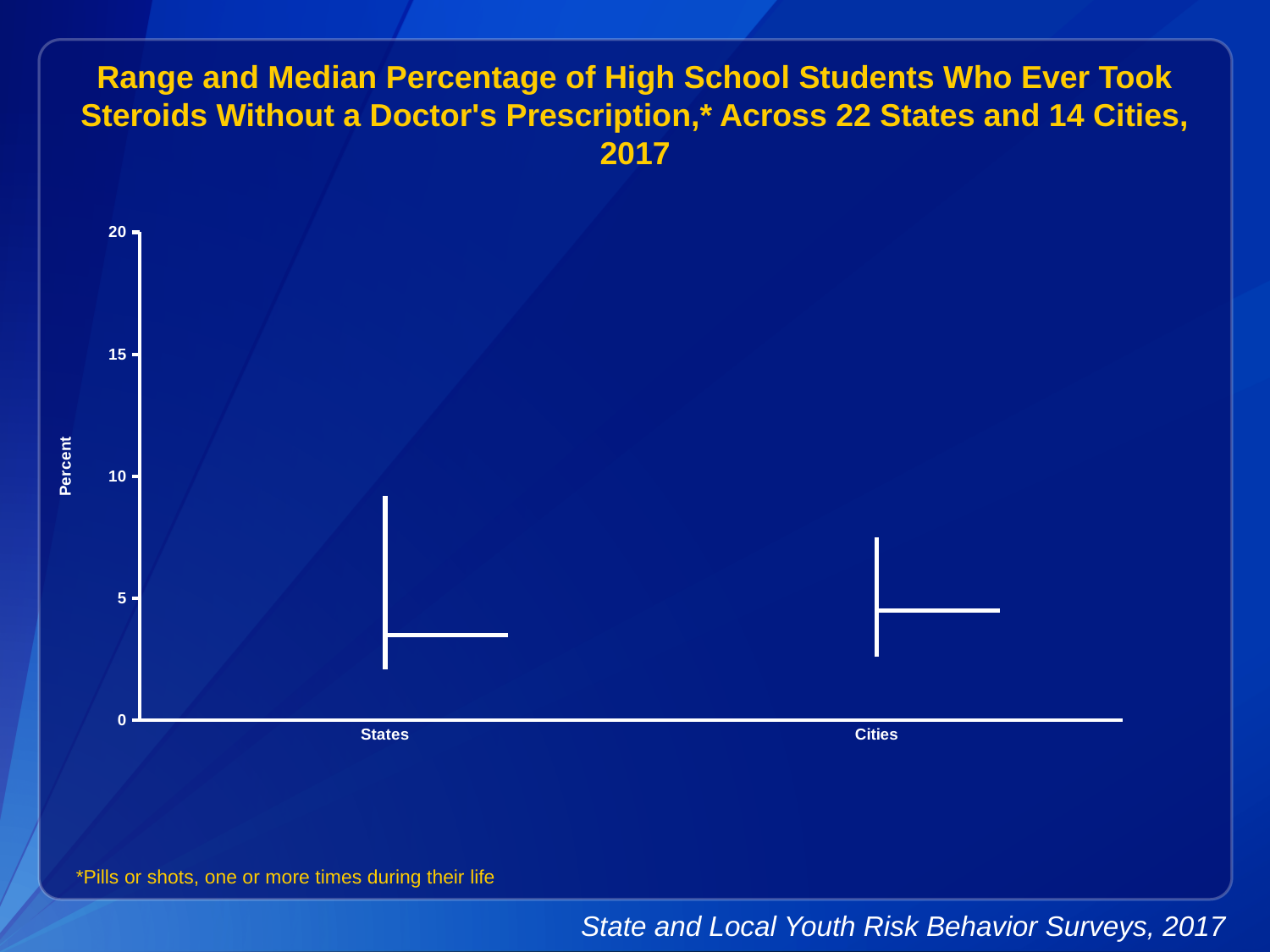
Which category has the higher median percentage, States or Cities? Cities Which category has the higher maximum (top of range), States or Cities? States How many categories are shown on the x axis of the chart? 2 Is the top of the range for Cities greater or less than 10? less Is the bottom of the range for Cities greater or less than 5? less Is the top of the range for States greater or less than 10? less What is the highest value shown on the y axis? 20 What is the label of the y axis? Percent According to the chart title, how many states and how many cities are included? 22 states and 14 cities